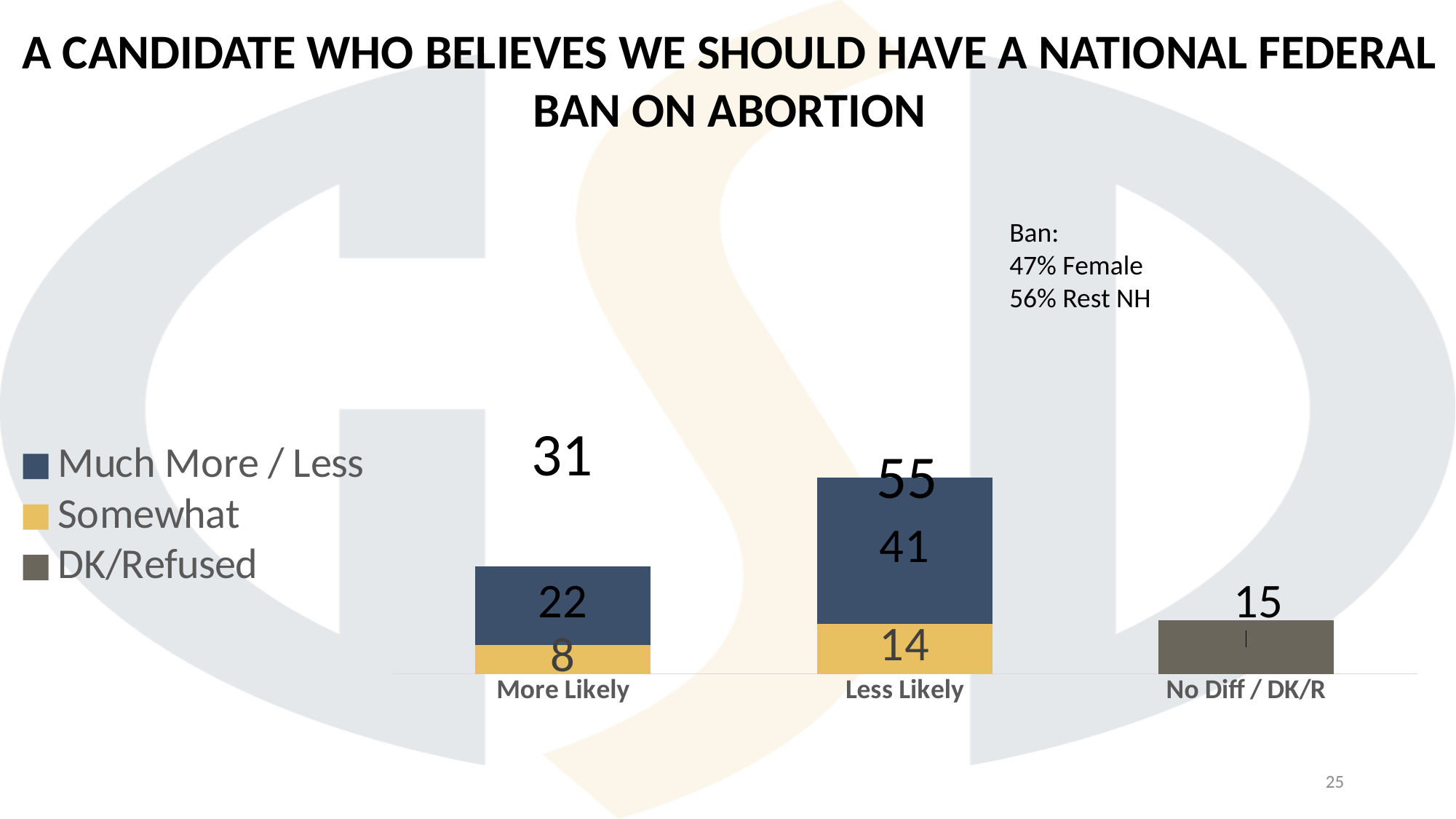
What is the 'Somewhat' value for the 'Less Likely' category? 14 How many categories are shown on the x axis of the chart? 3 What is the 'Much More / Less' value for the 'More Likely' category? 22 What total is printed above the 'Less Likely' bar? 55 What type of chart is shown on the slide? Stacked bar chart Which is larger: the 'Somewhat' value for 'Less Likely' or for 'More Likely'? Less Likely What value is shown for the 'No Diff / DK/R' category? 15 How many series does the chart's legend list? 3 Which category has the tallest bar? Less Likely What is the 'Somewhat' value for the 'More Likely' category? 8 What is the 'Much More / Less' value for the 'Less Likely' category? 41 What is the difference between the 'Much More / Less' values for 'Less Likely' and 'More Likely'? 19